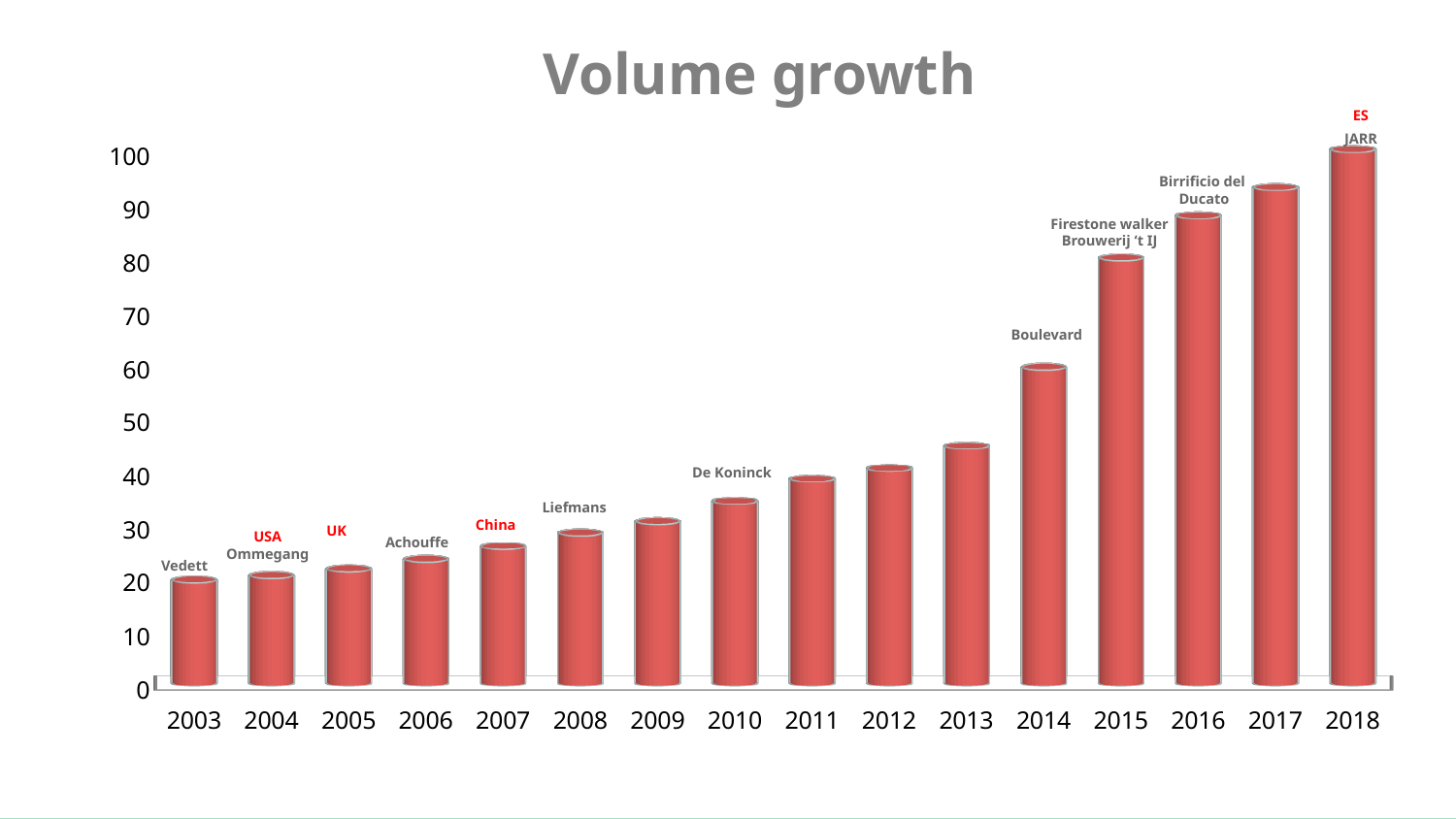
Which year has the lowest bar? 2003 Is the value for 2013 greater or less than 50? less What kind of chart is shown on the slide? bar chart Is the value for 2017 greater or less than 90? greater Which brewery name is annotated above the 2014 bar? Boulevard Is the value for 2015 greater or less than 70? greater Which year has the larger value, 2014 or 2012? 2014 Do the values rise or fall from 2003 to 2018? rise How many years are plotted on the x axis? 16 Which year has the highest bar? 2018 What is the title of the chart? Volume growth